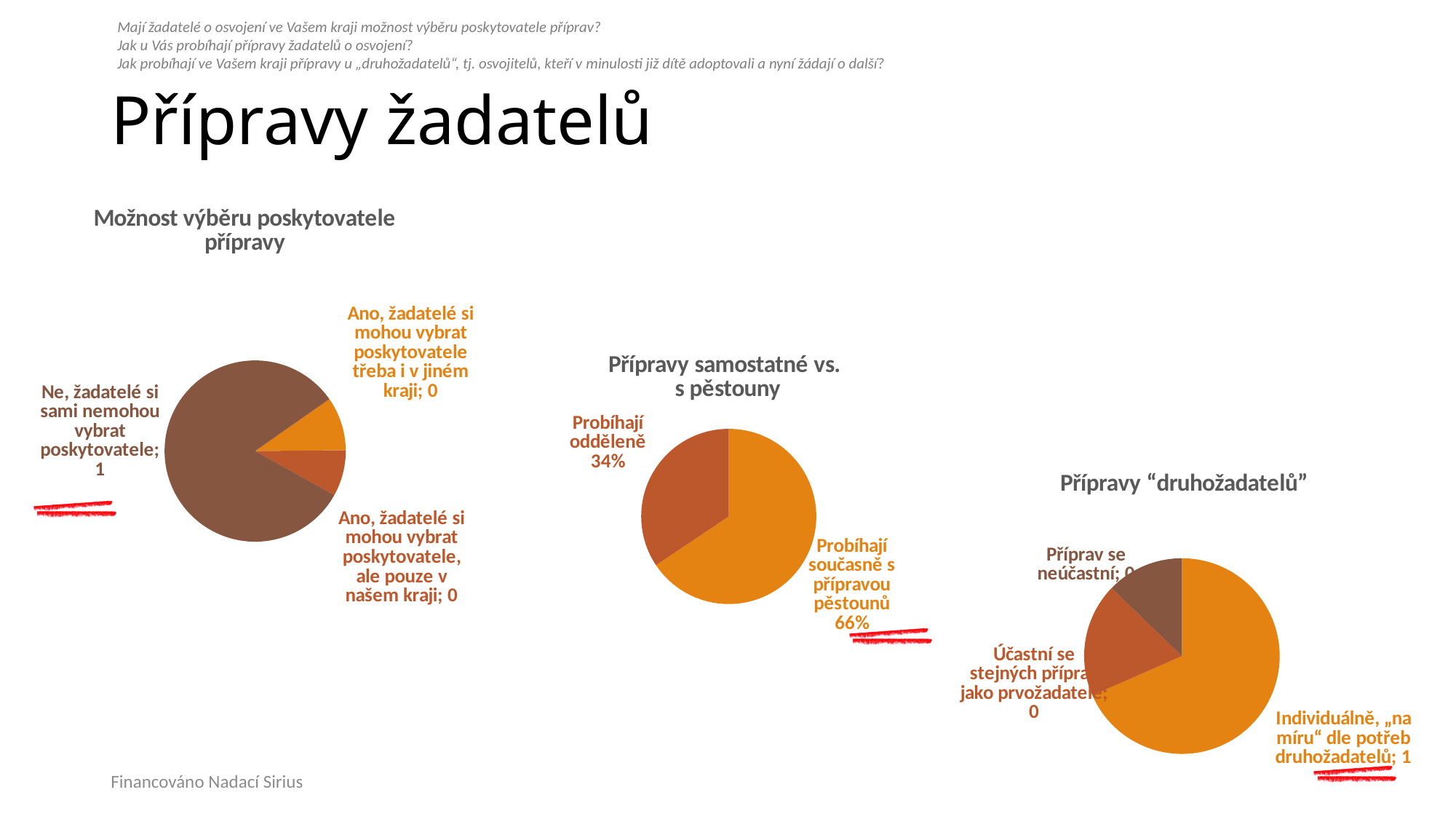
In the chart titled "Možnost výběru poskytovatele přípravy", what value is labelled for "Ne, žadatelé si sami nemohou vybrat poskytovatele"? 1 In the chart titled "Přípravy samostatné vs. s pěstouny", which slice is larger: "Probíhají odděleně" or "Probíhají současně s přípravou pěstounů"? Probíhají současně s přípravou pěstounů In the chart titled "Přípravy samostatné vs. s pěstouny", what is the difference in percentage points between the two slices? 32 percentage points How many pie charts are shown on the slide? 3 In the chart titled "Přípravy samostatné vs. s pěstouny", what share is labelled for "Probíhají současně s přípravou pěstounů"? 66% In the chart titled "Možnost výběru poskytovatele přípravy", which category has the largest slice? Ne, žadatelé si sami nemohou vybrat poskytovatele How many slices does the chart titled "Přípravy “druhožadatelů”" have? 3 What kind of chart is the chart titled "Přípravy samostatné vs. s pěstouny"? pie chart How many slices does the chart titled "Možnost výběru poskytovatele přípravy" have? 3 How many slices does the chart titled "Přípravy samostatné vs. s pěstouny" have? 2 In the chart titled "Přípravy “druhožadatelů”", which category has the largest slice? Individuálně, „na míru“ dle potřeb druhožadatelů In the chart titled "Přípravy samostatné vs. s pěstouny", what share is labelled for "Probíhají odděleně"? 34%